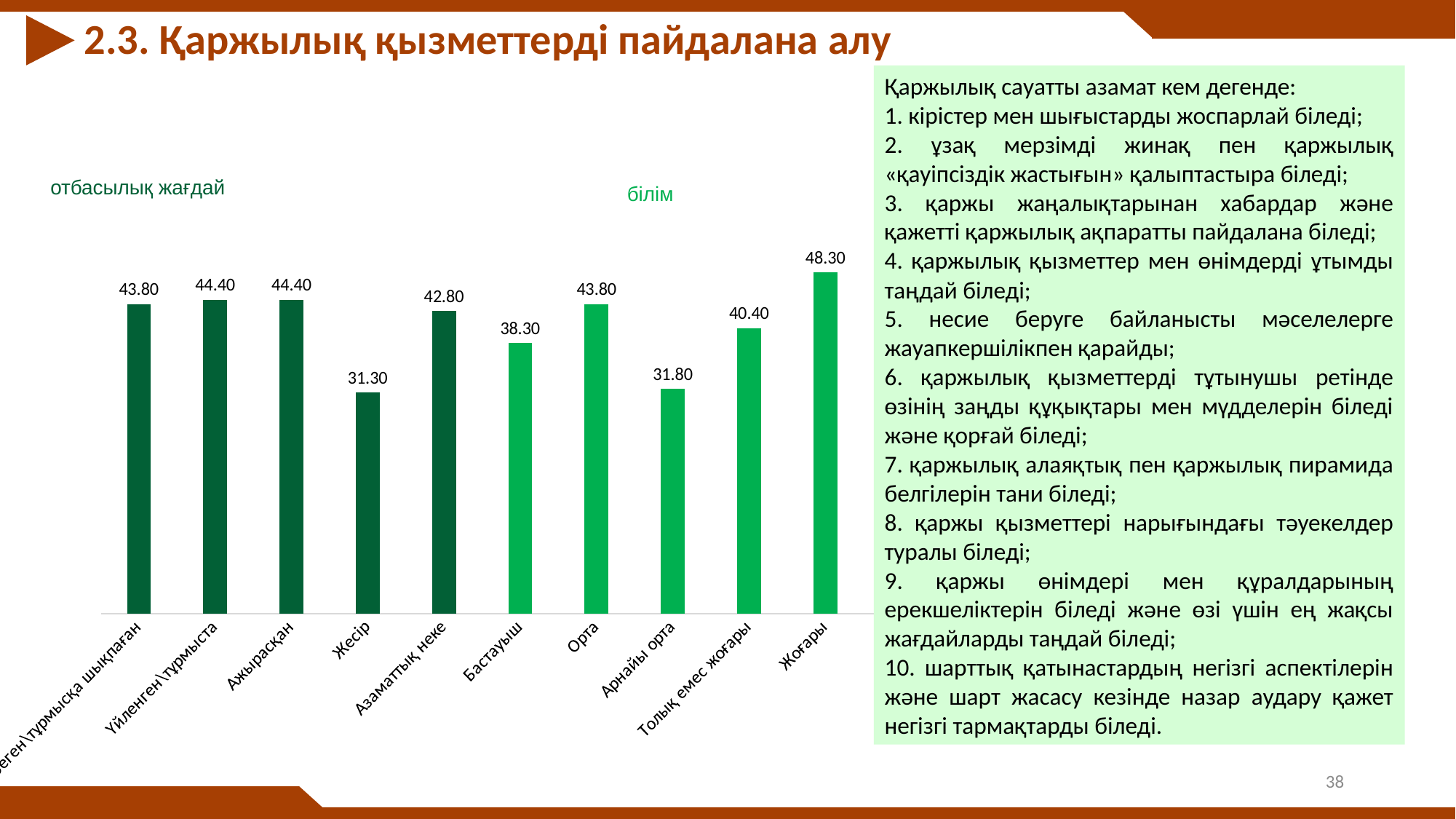
Which has a larger value, Орта or Толық емес жоғары? Орта What is the value for Жесір? 31.30 How many bars are shown in the chart? 10 What is the difference between the values for Жоғары and Жесір? 17.00 Which category has the lowest value in the chart? Жесір What is the value for Азаматтық неке? 42.80 What is the value for Жоғары? 48.30 Which category has the highest value in the chart? Жоғары What is the value for Бастауыш? 38.30 What are the two group labels shown above the bars? отбасылық жағдай and білім What kind of chart is shown on the slide? Bar chart What is the difference between the values for Толық емес жоғары and Арнайы орта? 8.60